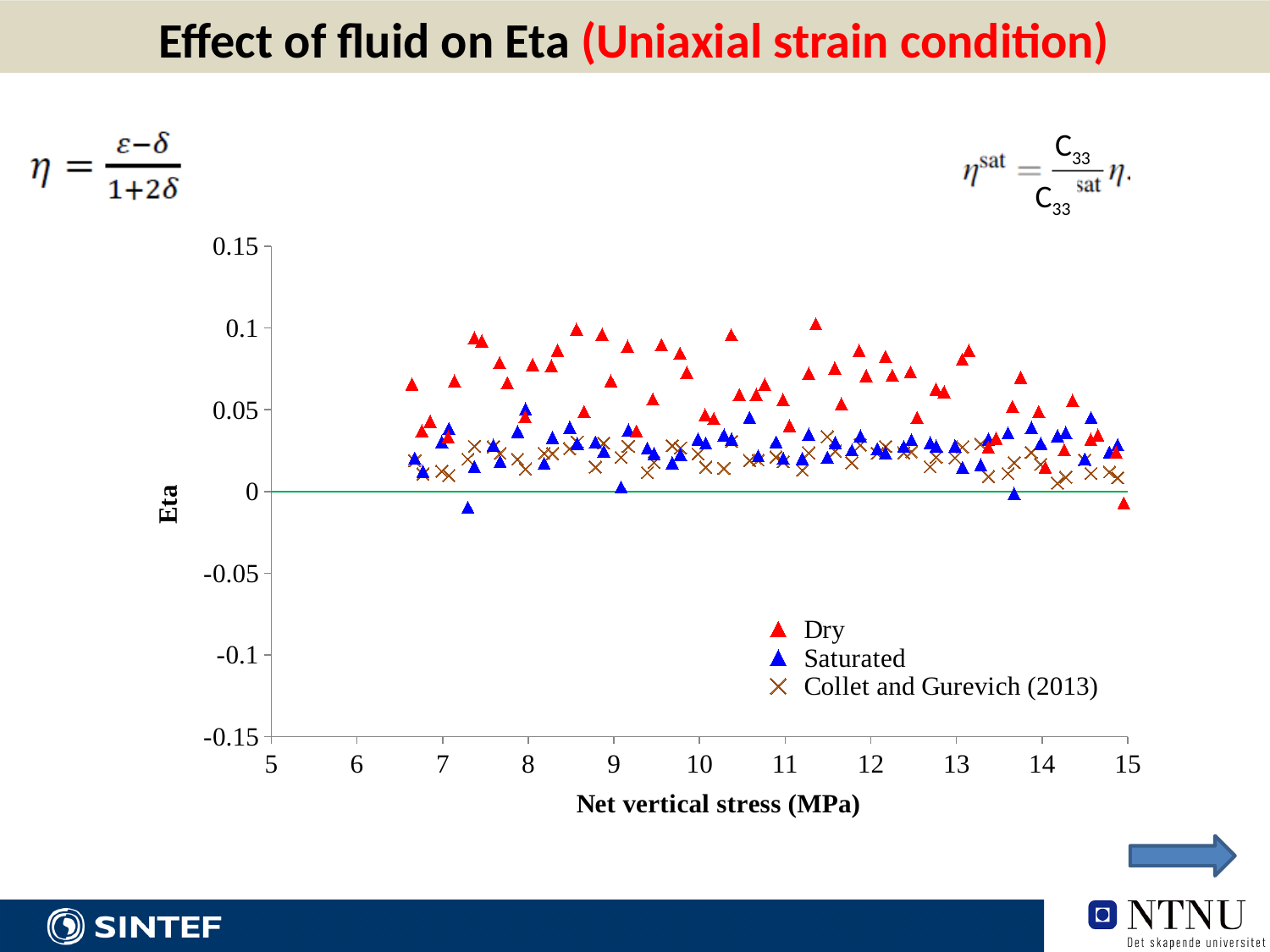
Are the Collet and Gurevich (2013) values greater or less than 0.05? less How many series does the legend list? 3 Is the Dry value at a net vertical stress of about 11.3 MPa greater or less than 0.05? greater What kind of chart is shown on the slide? Scatter chart Which series has generally higher Eta values, Dry or Saturated? Dry What is the title of the x axis? Net vertical stress (MPa) Are the Saturated values at a net vertical stress of 12 MPa greater or less than 0.05? less Which series is plotted with cross markers? Collet and Gurevich (2013)